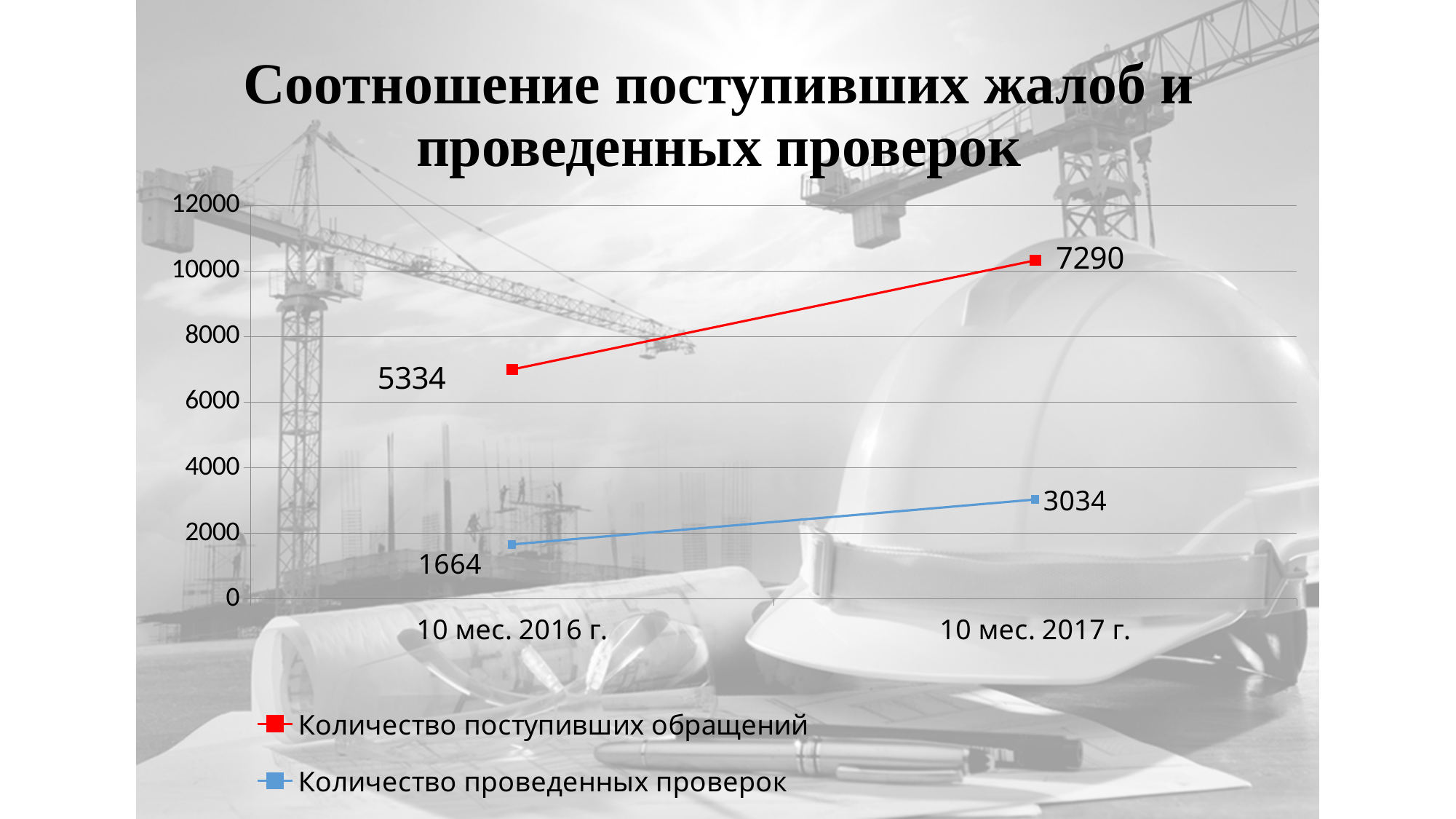
By how much did Количество проведенных проверок increase from 10 мес. 2016 г. to 10 мес. 2017 г.? 1370 What type of chart is shown on the slide? line chart By how much did Количество поступивших обращений increase from 10 мес. 2016 г. to 10 мес. 2017 г.? 1956 What colour is the line for Количество проведенных проверок? blue What is the value of Количество проведенных проверок for 10 мес. 2016 г.? 1664 How many series does the legend list? 2 Which series has the higher value for 10 мес. 2017 г.? Количество поступивших обращений How many categories are shown on the x axis? 2 Do the values of Количество проведенных проверок rise or fall from 10 мес. 2016 г. to 10 мес. 2017 г.? rise What is the value of Количество проведенных проверок for 10 мес. 2017 г.? 3034 What is the value of Количество поступивших обращений for 10 мес. 2016 г.? 5334 What is the value of Количество поступивших обращений for 10 мес. 2017 г.? 7290